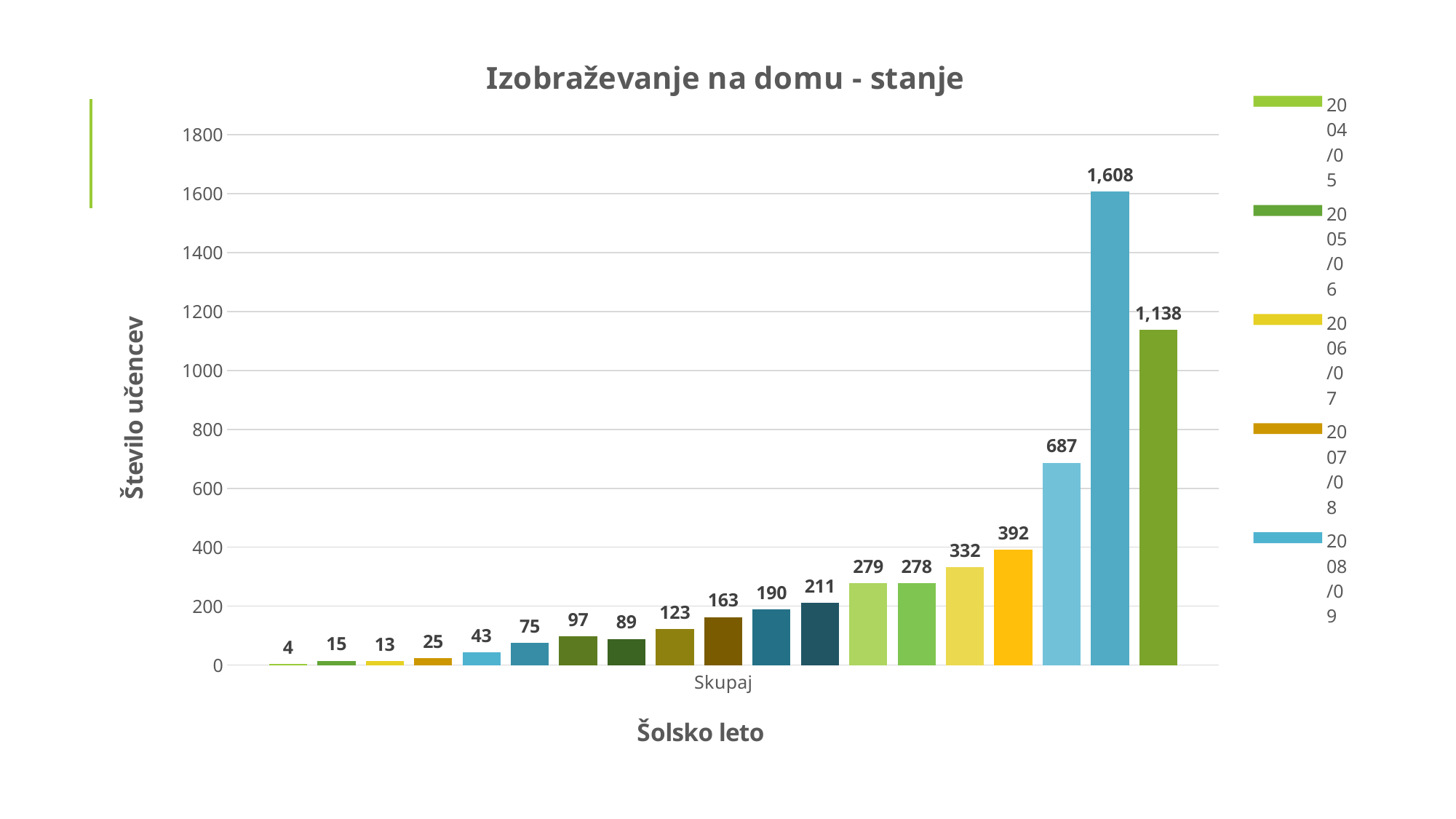
What is the title of the chart? Izobraževanje na domu - stanje What is the value for the 2008/09 series? 43 What is the lowest value shown in the chart? 4 What is the difference between the 2007/08 value and the 2006/07 value? 12 How many bars are plotted in the chart? 19 What is the label of the vertical axis? Število učencev Which is larger, the bar labelled 687 or the bar labelled 392? 687 What is the difference between the two tallest bars, 1,608 and 1,138? 470 What is the highest value shown in the chart? 1,608 What type of chart is shown on the slide? bar chart What is the value for the 2007/08 series? 25 What is the value for the 2004/05 series? 4